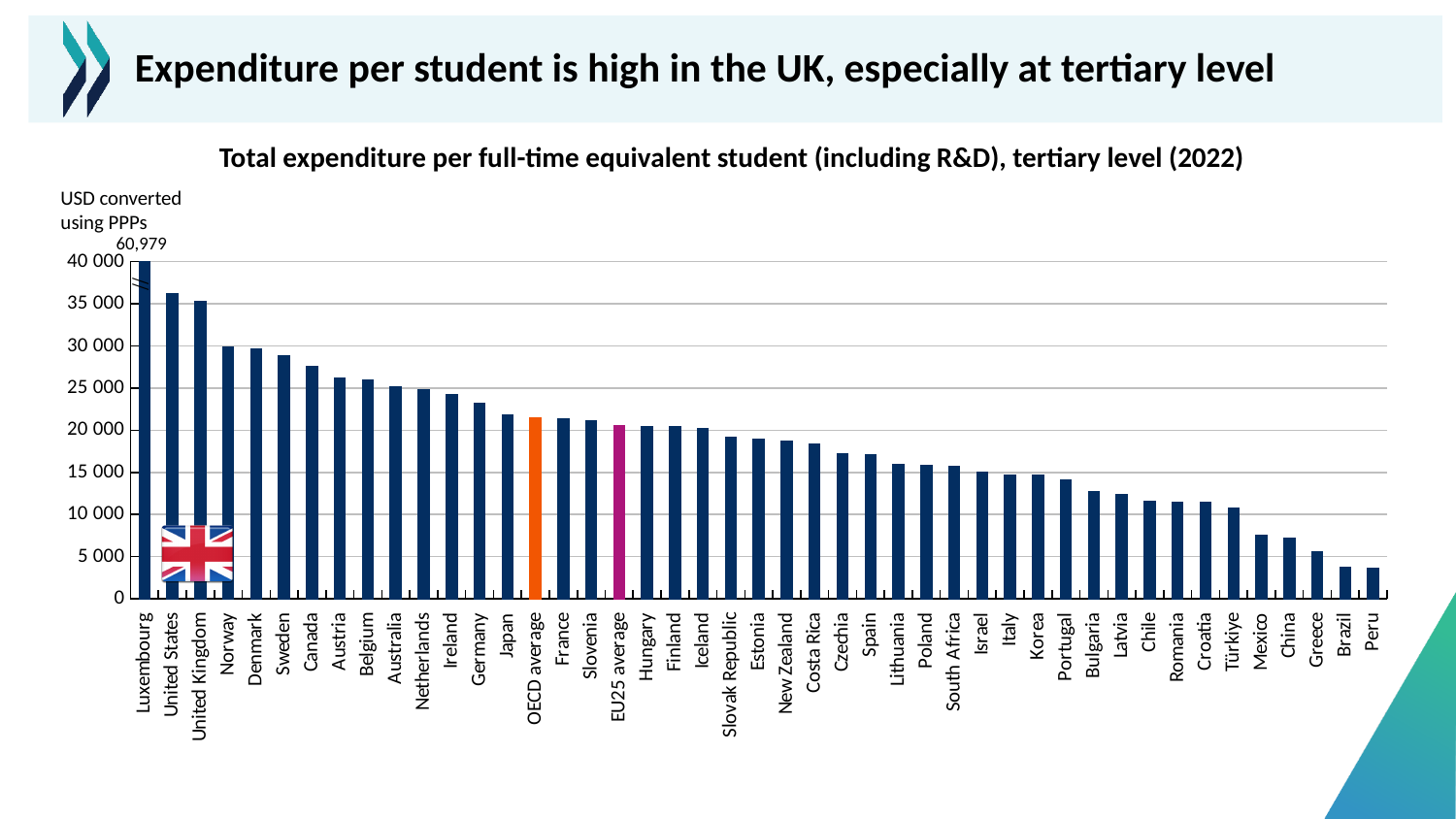
Which country has the lowest expenditure per student? Peru Is the value for the United Kingdom greater or less than 30 000? greater Do the values rise or fall from left to right along the x axis? Fall Is the value for Germany greater or less than 20 000? greater Is the value for Mexico greater or less than 10 000? less What kind of chart is shown on the slide? Bar chart Which has a higher value, Chile or Spain? Spain Which country has the highest expenditure per student? Luxembourg How many bars are shown in the chart? 45 What is the value for Luxembourg? 60,979 Which has a higher value, Sweden or Ireland? Sweden